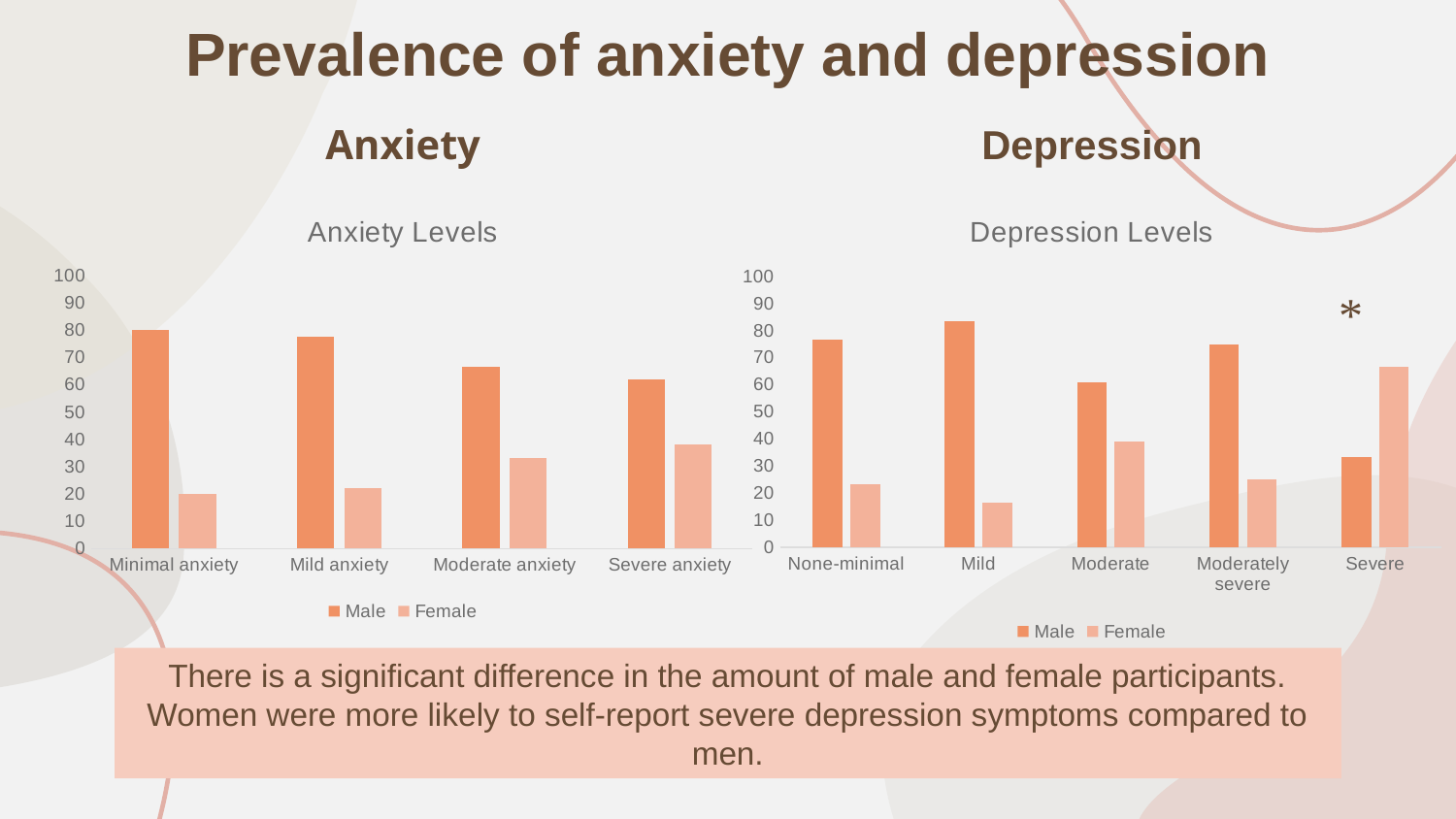
In the Depression Levels chart, is the Female value for Severe greater or less than 60? greater In the Depression Levels chart, which category has the lowest Male value? Severe How many categories are shown on the x axis of the Anxiety Levels chart? 4 What kind of chart is the Anxiety Levels chart? bar chart In the Depression Levels chart, which category has the highest Male value? Mild How many categories are shown on the x axis of the Depression Levels chart? 5 In the Anxiety Levels chart, do the Male values rise or fall from Minimal anxiety to Severe anxiety? fall In the Anxiety Levels chart, which category has the highest Female value? Severe anxiety In the Depression Levels chart, which is larger for the Severe category, the Male value or the Female value? Female In the Anxiety Levels chart, which category has the highest Male value? Minimal anxiety How many series does the legend of the Depression Levels chart list? 2